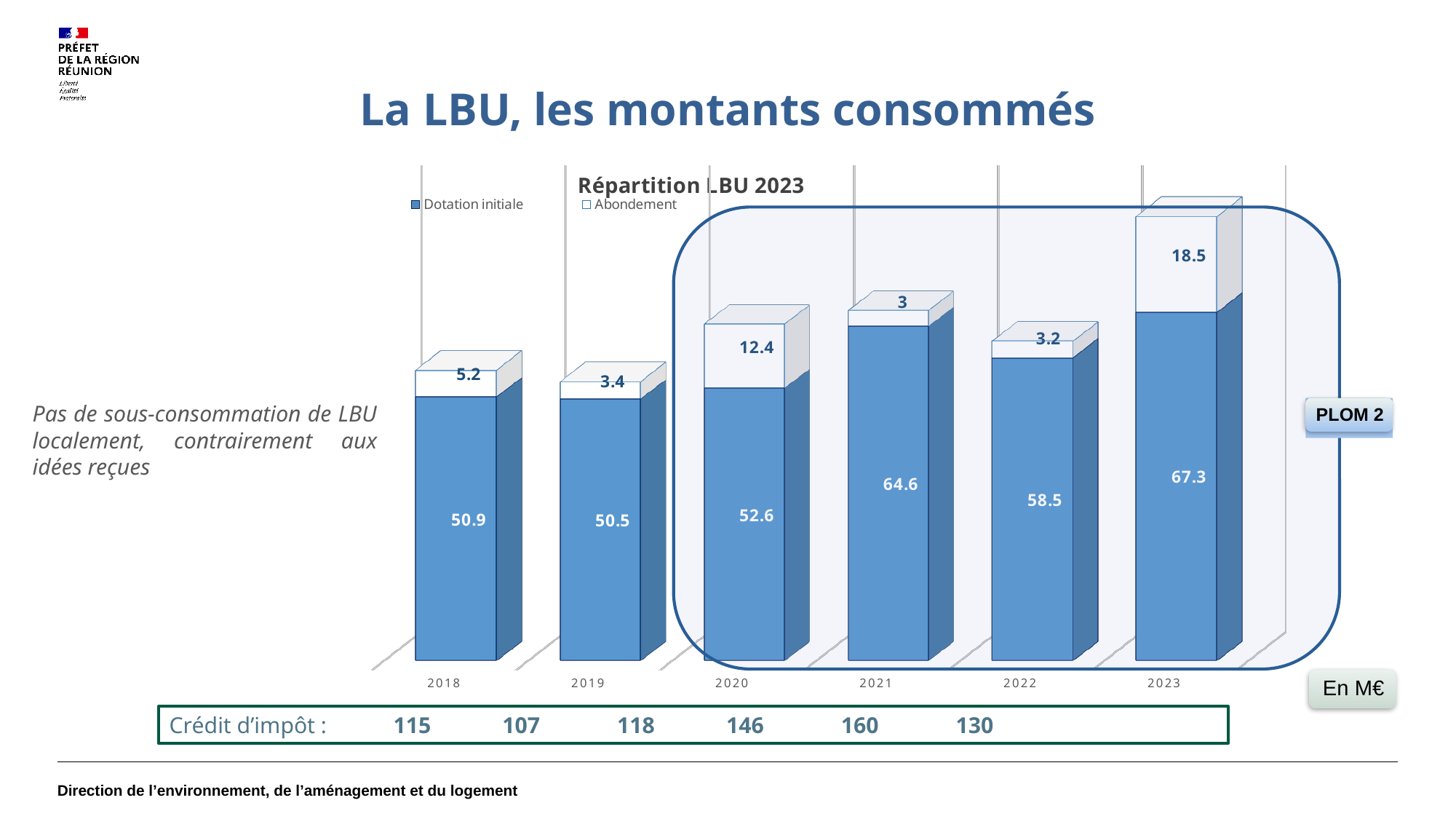
What kind of chart is shown on the slide? Stacked bar chart What is the difference between the Dotation initiale values for 2023 and 2022? 8.8 Which year has the highest Dotation initiale value? 2023 What is the Abondement value for 2020? 12.4 What is the Dotation initiale value for 2021? 64.6 How many years are shown on the x axis of the chart? 6 Which year has the lowest Abondement value? 2021 What is the title of the chart? Répartition LBU 2023 How many series does the chart legend list? 2 What is the total of the stacked bar for 2023? 85.8 Which is larger, the Abondement value for 2018 or for 2019? 2018 What is the Abondement value for 2023? 18.5